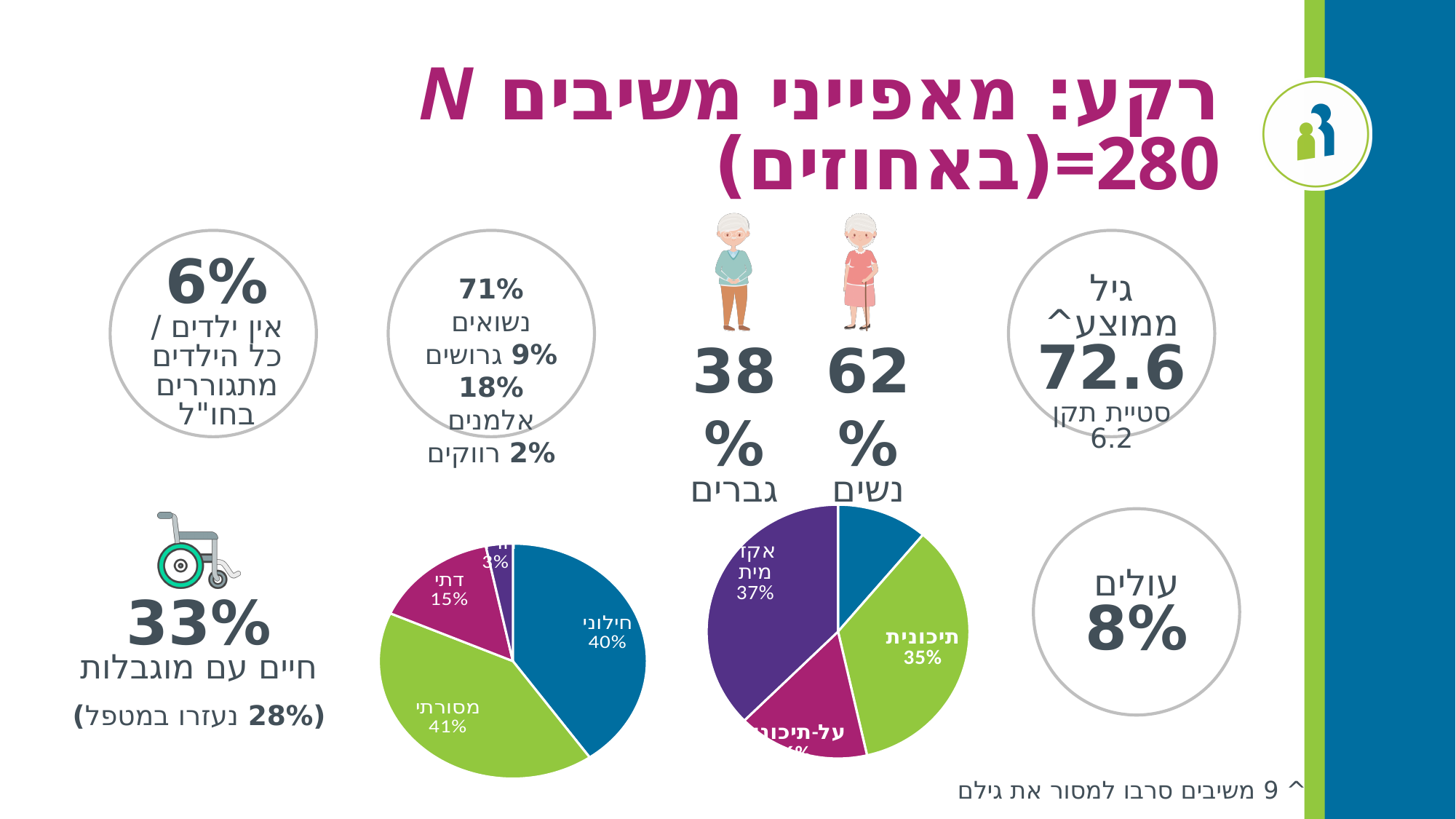
In the right pie chart, which is larger, אקדמית or תיכונית? אקדמית In the left pie chart, what is the value for מסורתי? 41% In the left pie chart, what is the value for חילוני? 40% In the left pie chart, which is larger, חילוני or דתי? חילוני What kind of chart is the left chart on the slide (the one with חילוני and מסורתי)? pie chart In the left pie chart, what is the value for דתי? 15% In the right pie chart, what is the value for אקדמית? 37% How many slices does the left pie chart have? 4 In the right pie chart, what is the value for תיכונית? 35% In the left pie chart, what is the difference between מסורתי and דתי? 26 percentage points In the left pie chart, which category has the largest share? מסורתי In the left pie chart, what colour is the חילוני slice? blue